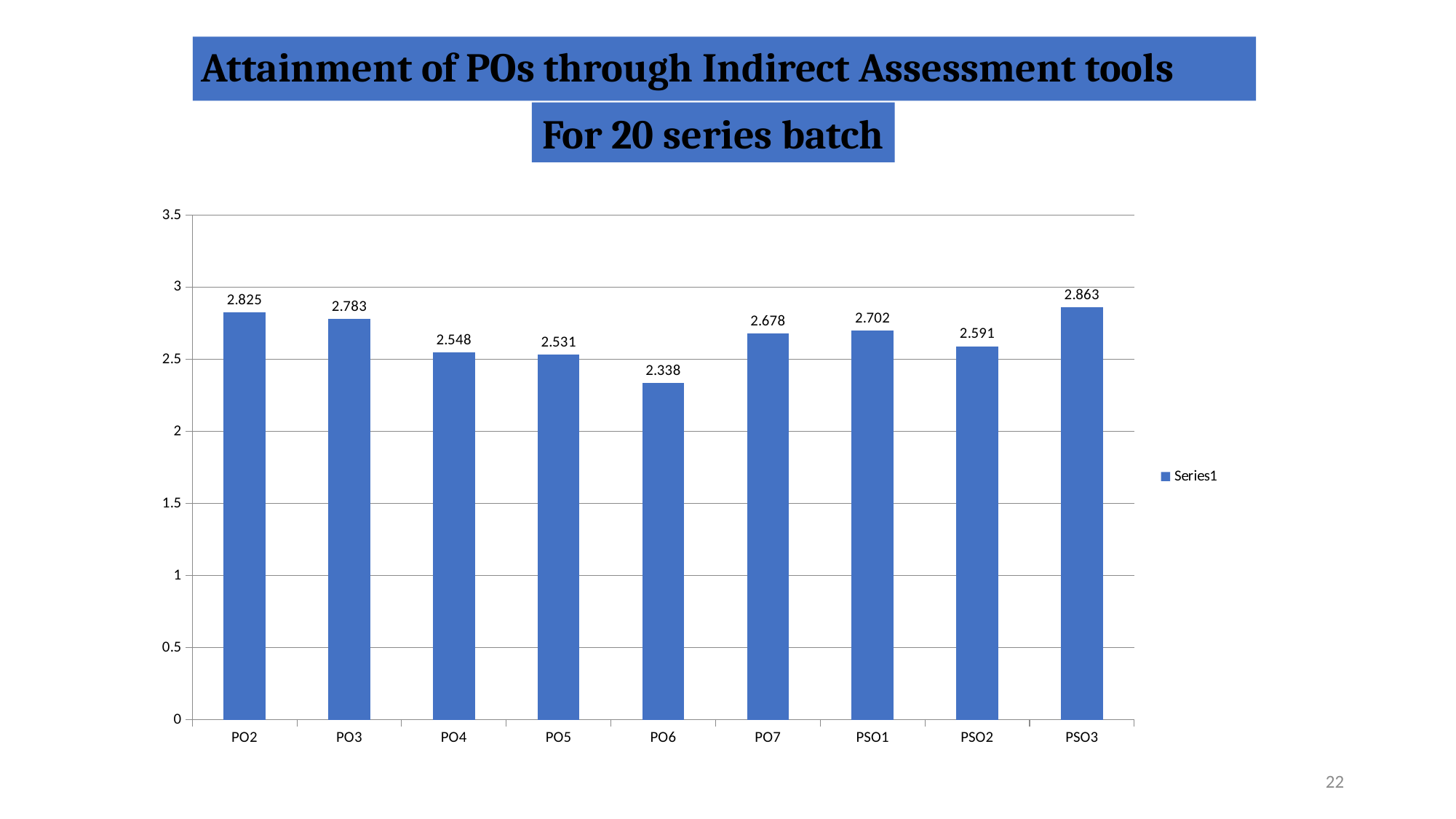
Which is larger, the value for PO7 or the value for PSO1? PSO1 Which category has the highest value? PSO3 Which category has the lowest value? PO6 What kind of chart is shown on the slide? bar chart Is the value for PO4 greater or less than 2.5? greater What is the value for PSO2? 2.591 How many series does the legend list? 1 How many categories are shown on the x axis? 9 What is the value for PO2? 2.825 What is the name of the series shown in the legend? Series1 What is the difference between the values for PSO3 and PO6? 0.525 What is the value for PO6? 2.338